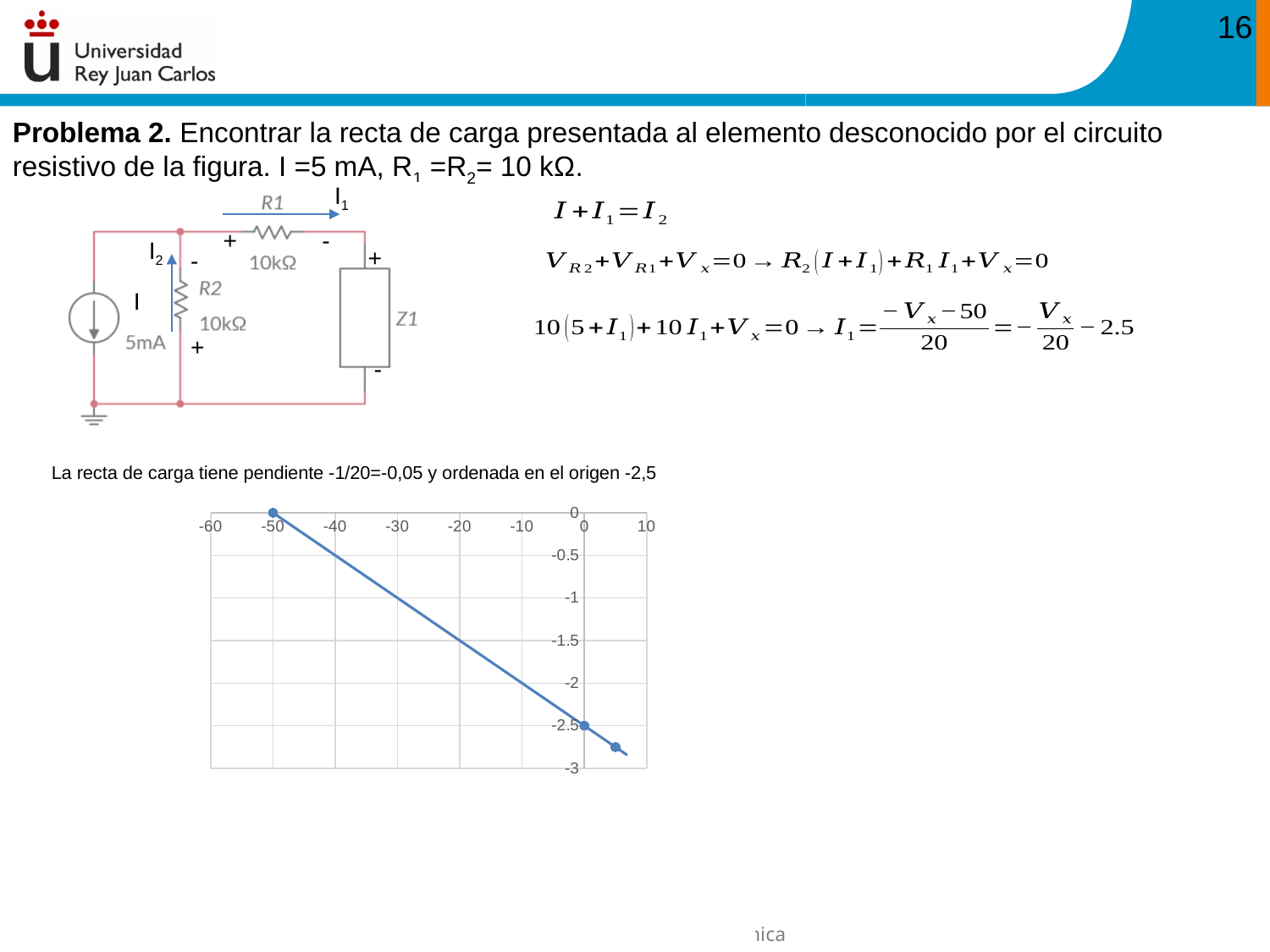
What is the leftmost tick label shown on the x axis? -60 Is the y value of the line at x = -20 greater or less than -2? greater How many marked data points are plotted on the chart? 3 What is the difference between the y value at x = -50 and the y value at x = 0? 2.5 Is the y value of the line at x = -20 greater or less than -1? less Which point has the higher y value: the one at x = -50 or the one at x = 0? the one at x = -50 Do the plotted values rise or fall as x increases along the x axis? fall What is the y value of the plotted point at x = 0? -2.5 What kind of chart is shown on the slide? line chart What is the y value of the plotted point at x = -50? 0 Which plotted point has the lowest y value: the leftmost or the rightmost? the rightmost What is the lowest tick label shown on the y axis? -3